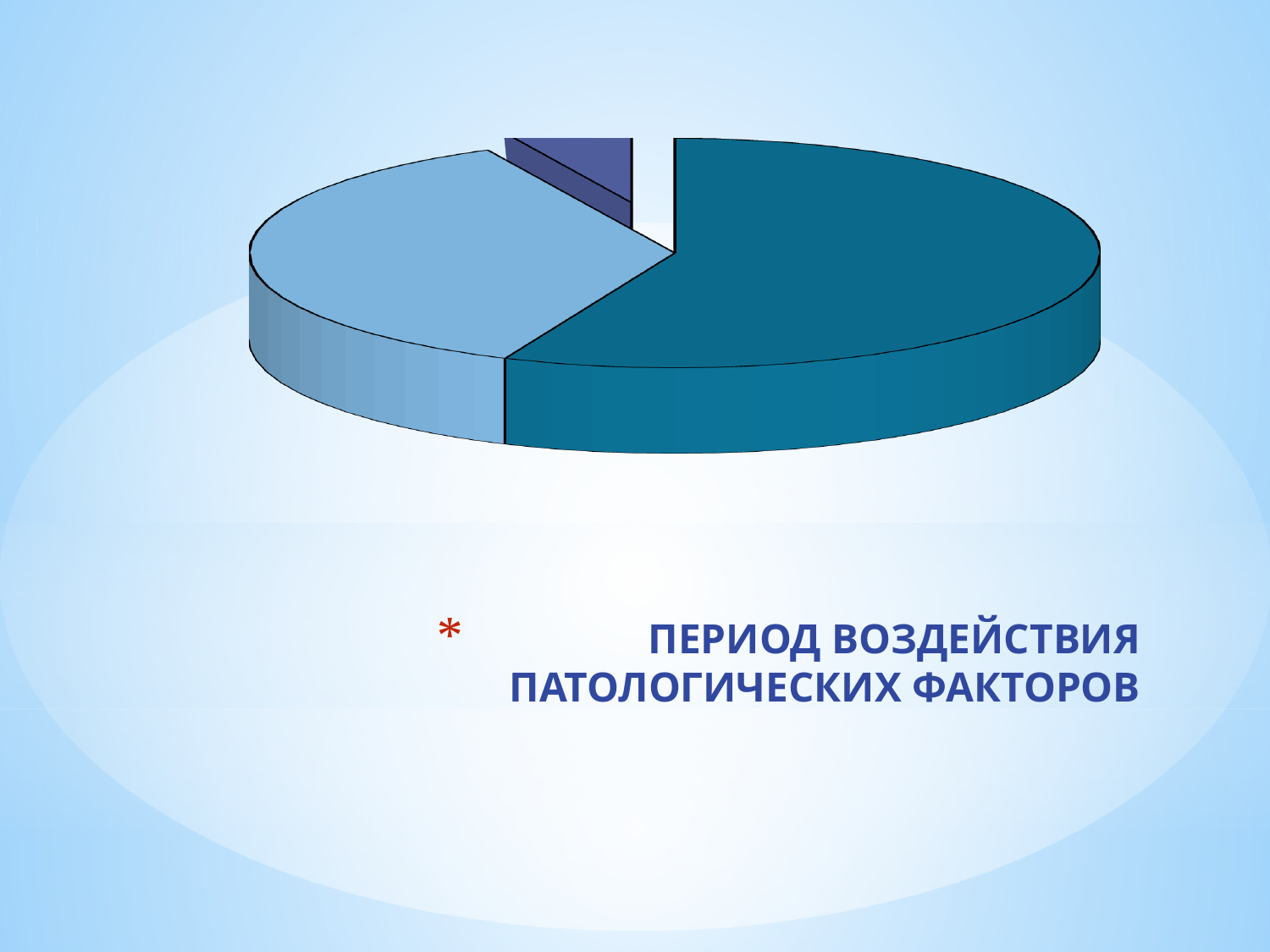
Does the dark teal slice take up more or less than half of the pie? more Does the pie chart display a legend? no What kind of chart is shown on the slide? pie chart Which colour slice of the pie chart is the largest? dark teal How many slices does the pie chart have? 3 What is the title text shown below the pie chart? ПЕРИОД ВОЗДЕЙСТВИЯ ПАТОЛОГИЧЕСКИХ ФАКТОРОВ Is the dark teal slice larger or smaller than the light blue slice? larger Which colour slice of the pie chart is the smallest? dark blue-purple